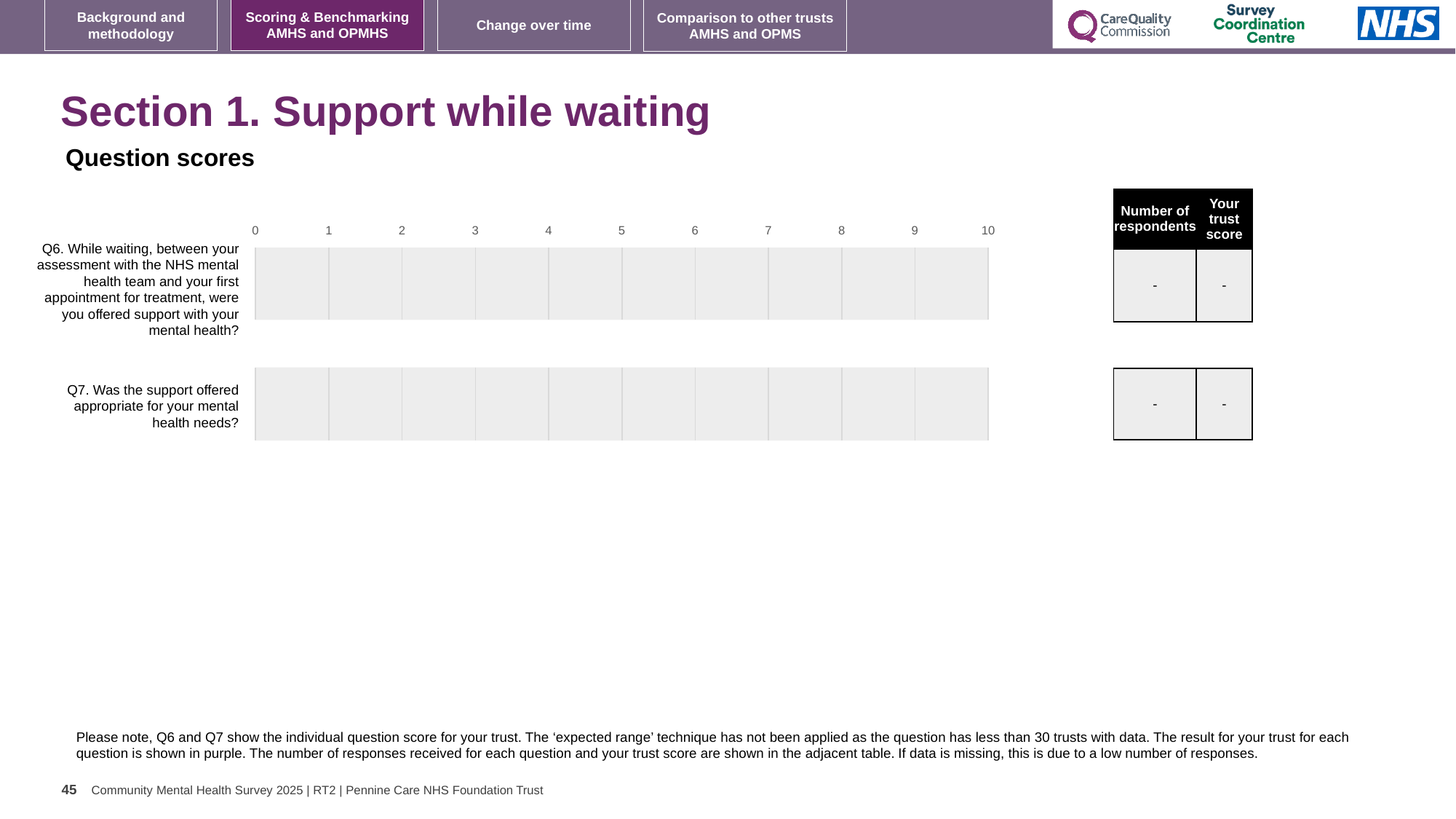
What is the lowest value shown on the chart's horizontal axis? 0 What is shown in the 'Number of respondents' column for Q7 in the adjacent table? - What kind of chart is shown on the slide? bar chart How many questions (categories) are listed on the chart? 2 Are any bars plotted for Q6 or Q7 on the chart? No What is shown in the 'Your trust score' column for Q6 in the adjacent table? - What is the highest value shown on the chart's horizontal axis? 10